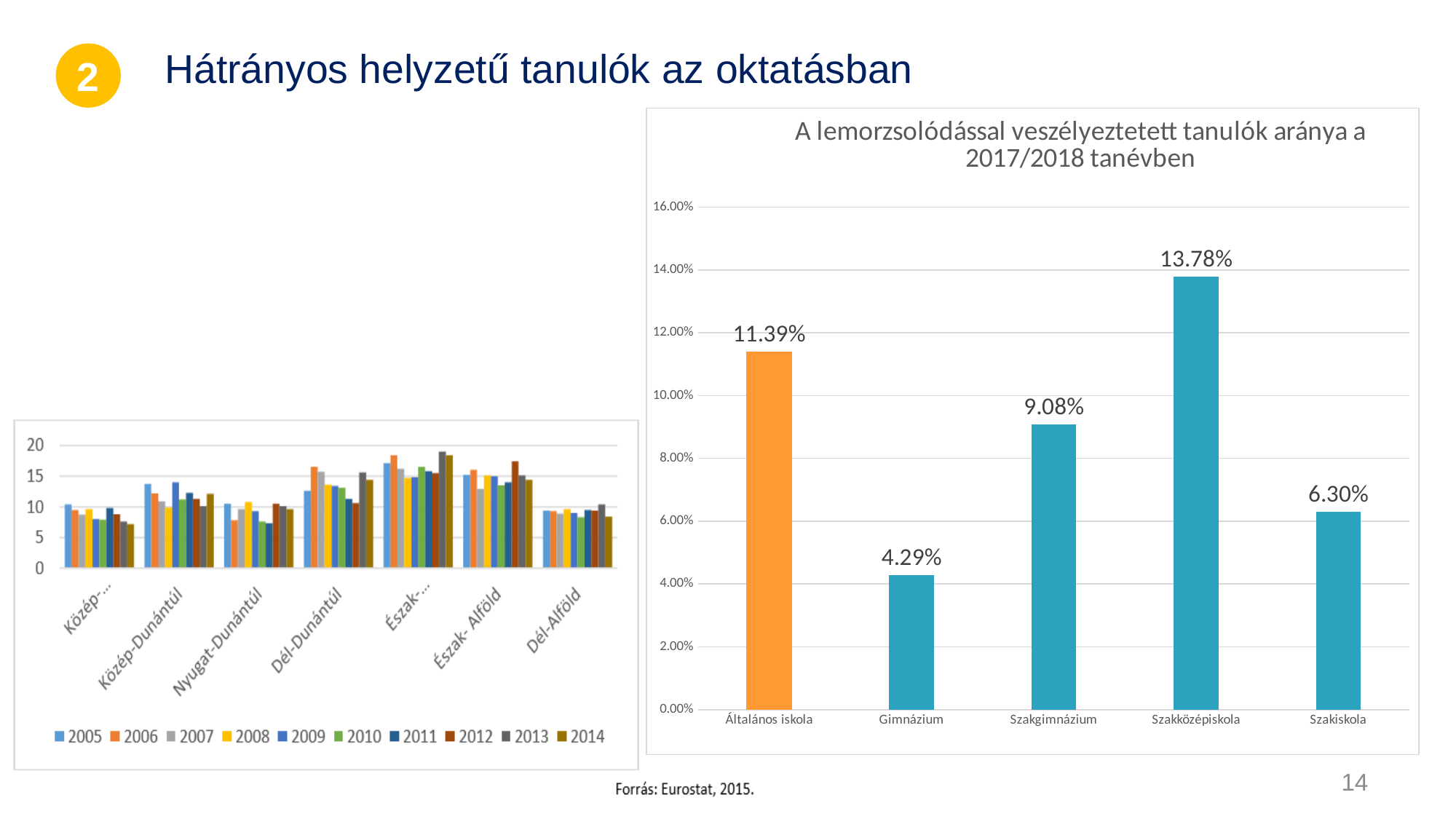
In the chart titled 'A lemorzsolódással veszélyeztetett tanulók aránya a 2017/2018 tanévben', what is the difference between Szakközépiskola and Szakiskola? 7.48% In the chart titled 'A lemorzsolódással veszélyeztetett tanulók aránya a 2017/2018 tanévben', which category has the lowest value? Gimnázium In the chart titled 'A lemorzsolódással veszélyeztetett tanulók aránya a 2017/2018 tanévben', how many categories are shown? 5 In the chart titled 'A lemorzsolódással veszélyeztetett tanulók aránya a 2017/2018 tanévben', which category has the highest value? Szakközépiskola In the chart titled 'A lemorzsolódással veszélyeztetett tanulók aránya a 2017/2018 tanévben', what is the value for Szakközépiskola? 13.78% In the chart on the left side of the slide, is the value for Dél-Dunántúl in 2006 greater or less than 15? greater In the chart titled 'A lemorzsolódással veszélyeztetett tanulók aránya a 2017/2018 tanévben', which bar is coloured orange? Általános iskola In the chart titled 'A lemorzsolódással veszélyeztetett tanulók aránya a 2017/2018 tanévben', what is the value for Gimnázium? 4.29% What kind of chart is the chart on the left side of the slide? Bar chart In the chart titled 'A lemorzsolódással veszélyeztetett tanulók aránya a 2017/2018 tanévben', what is the value for Általános iskola? 11.39% In the chart titled 'A lemorzsolódással veszélyeztetett tanulók aránya a 2017/2018 tanévben', which is larger: Szakgimnázium or Általános iskola? Általános iskola In the chart on the left side of the slide, how many series does the legend list? 10